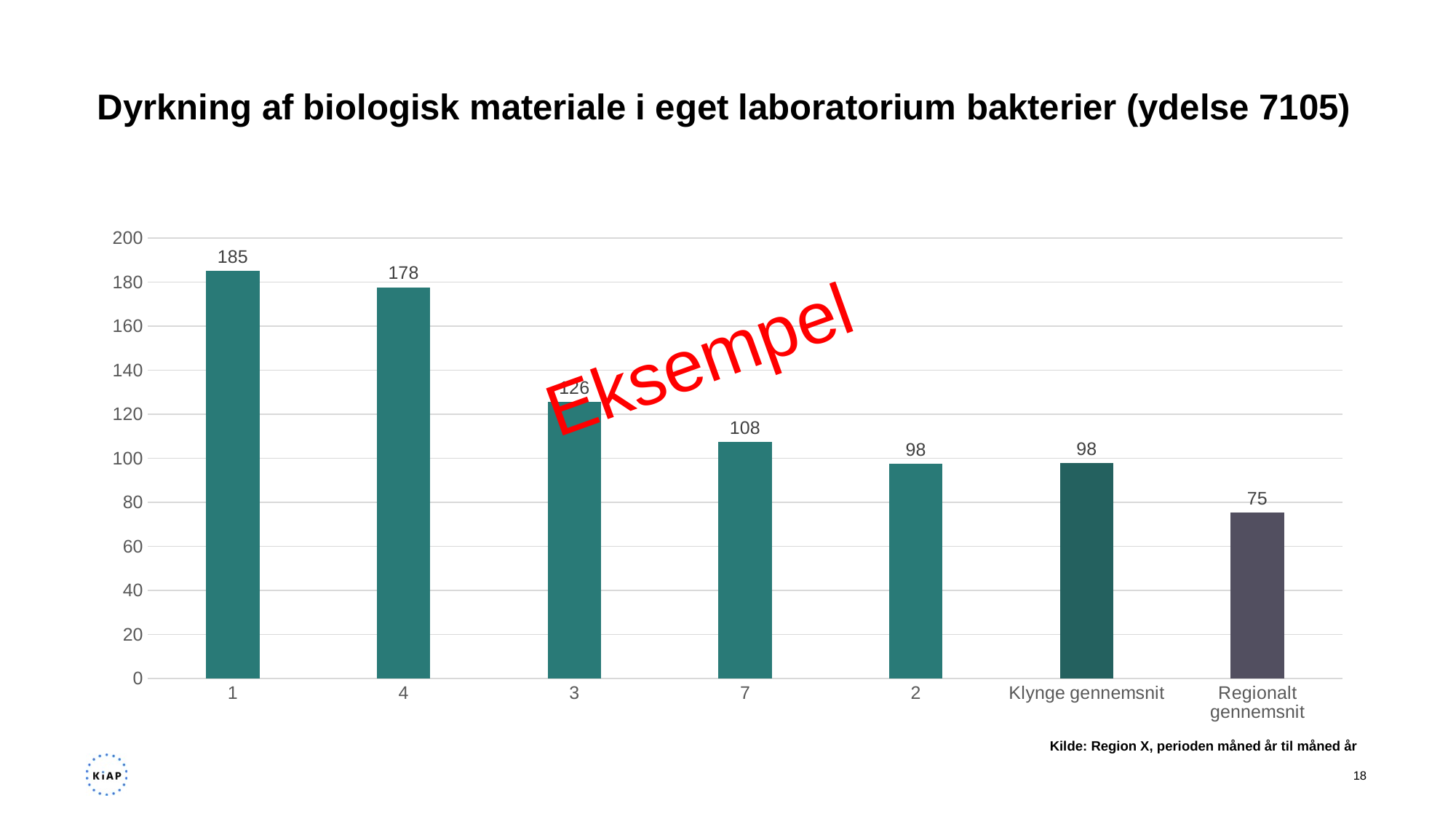
Which category has the lowest value? Regionalt gennemsnit What kind of chart is shown on the slide? bar chart Which category has the highest value? 1 What is the value for Regionalt gennemsnit? 75 What is the difference between the values for category 1 and category 4? 7 What is the value for category 4? 178 What is the value for category 7? 108 Which is larger, the value for category 7 or the value for category 2? 7 How many bars are shown in the chart? 7 What is the difference between Klynge gennemsnit and Regionalt gennemsnit? 23 What is the value for Klynge gennemsnit? 98 What is the value for category 1? 185